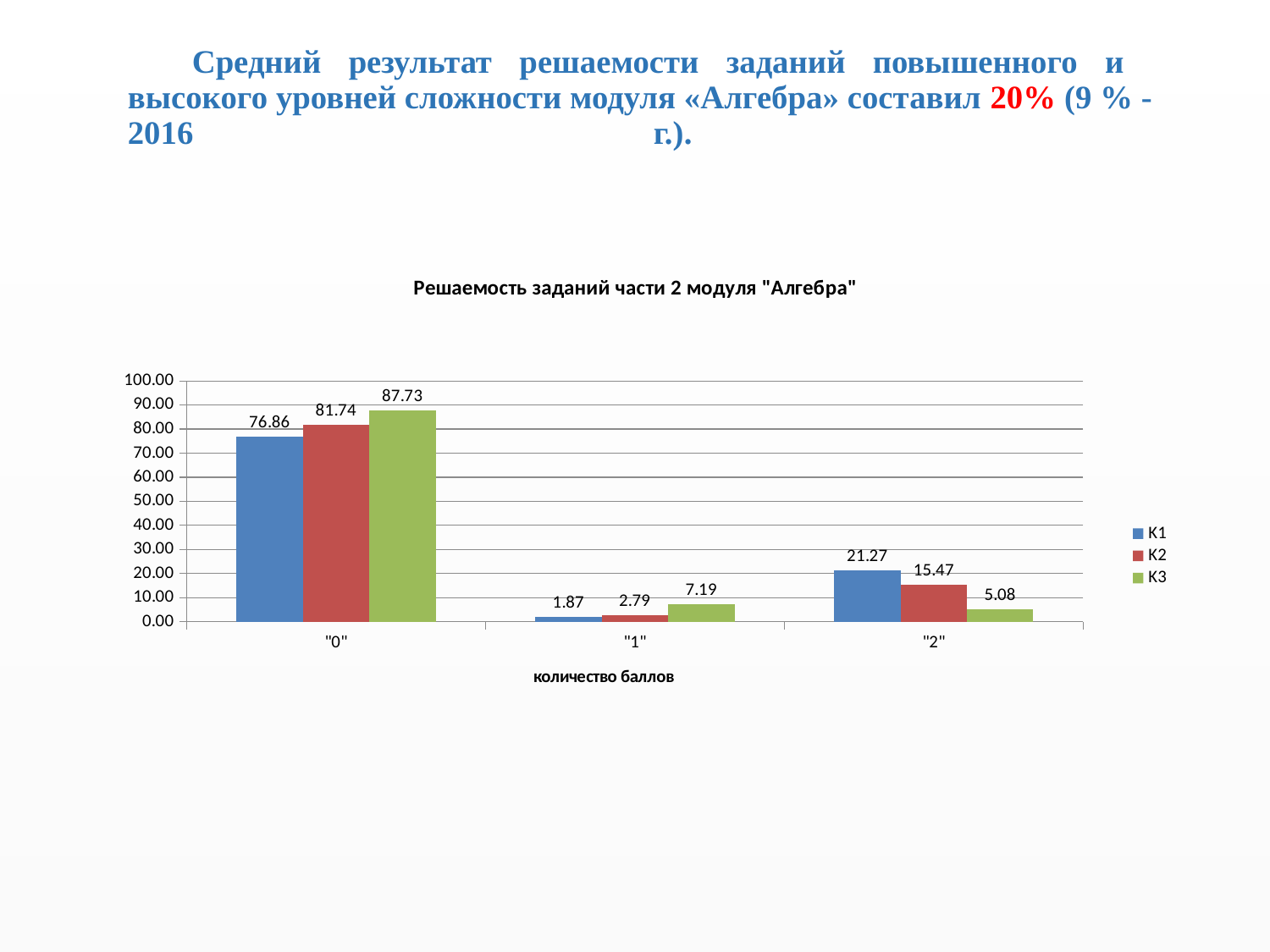
Is the value for К2 in the "0" category greater or less than 80.00? greater What is the value for К3 in the "2" category? 5.08 Which series has the highest value in the "0" category? К3 What kind of chart is shown on the slide? bar chart What is the difference between the К3 and К1 values in the "0" category? 10.87 How many series does the legend list? 3 Which is larger in the "2" category, К1 or К3? К1 What is the value for К1 in the "0" category? 76.86 What is the value for К2 in the "1" category? 2.79 What is the difference between the К1 and К2 values in the "2" category? 5.80 How many categories are shown on the x axis? 3 Which series has the lowest value in the "1" category? К1